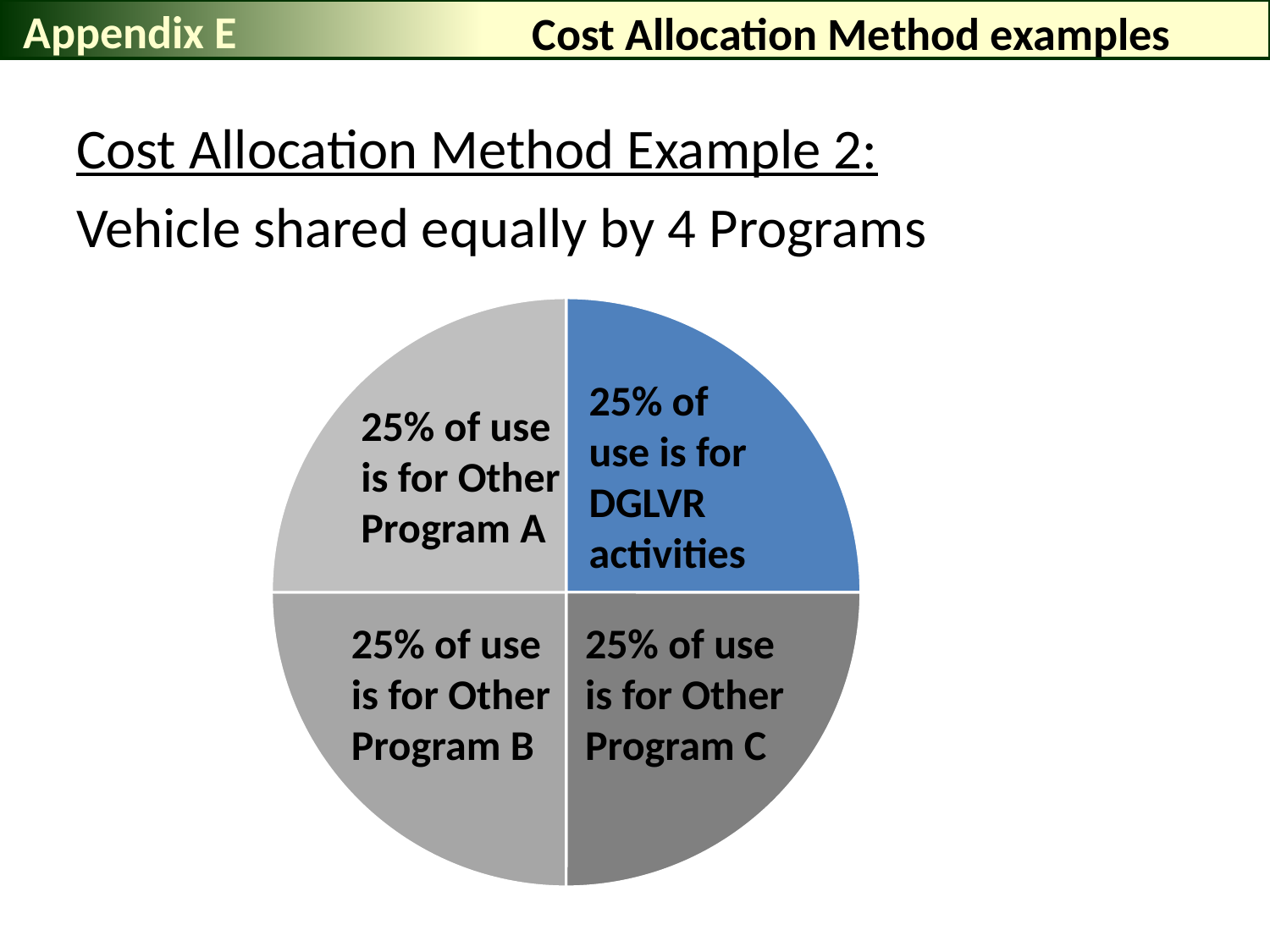
What share of vehicle use is for Other Program A? 25% What share of vehicle use is for Other Program C? 25% Which slice of the pie chart is coloured blue? 25% of use is for DGLVR activities What share of vehicle use is for DGLVR activities? 25% According to the slide text, how many programs share the vehicle equally? 4 What kind of chart is shown on the slide? pie chart Is the share of use for DGLVR activities greater or less than 50%? less What share of vehicle use is for Other Program B? 25% What is the difference between the share for DGLVR activities and the share for Other Program C? 0% What is the combined share of use for Other Program A, Other Program B and Other Program C? 75% How many slices does the pie chart have? 4